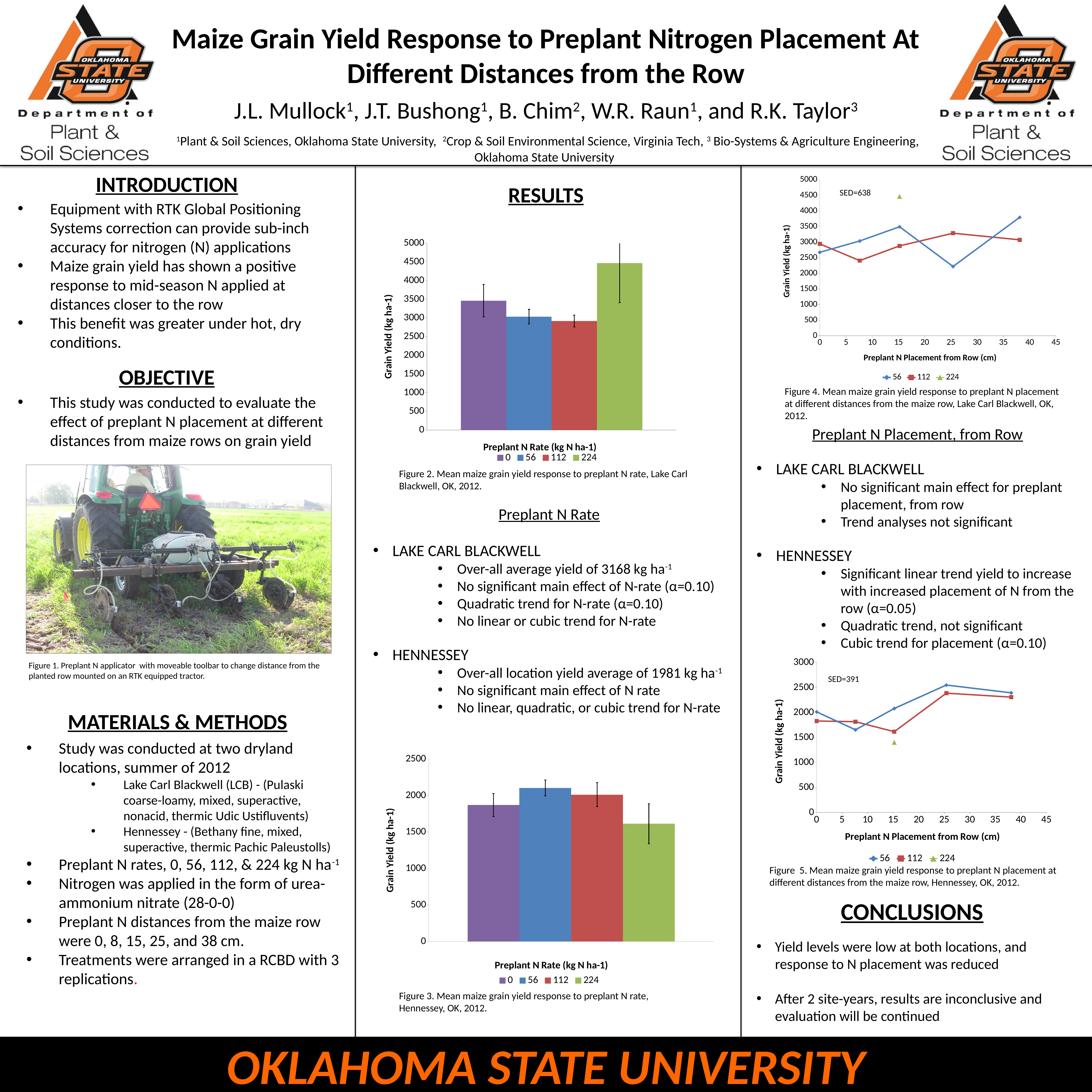
In Figure 2 (Lake Carl Blackwell, preplant N rate), what kind of chart is shown? bar chart In Figure 3 (Hennessey, preplant N rate), which N rate has the lowest grain yield? 224 In Figure 5 (Hennessey, preplant N placement), at 25 cm, which series has the higher grain yield, 56 or 112? 56 In Figure 5 (Hennessey, preplant N placement), what kind of chart is shown? line chart In Figure 2 (Lake Carl Blackwell, preplant N rate), how many N rates are plotted? 4 In Figure 3 (Hennessey, preplant N rate), is the grain yield for the 56 rate greater or less than 2000? greater In Figure 4 (Lake Carl Blackwell, preplant N placement), is the grain yield for the 56 series at 25 cm greater or less than 2500? less In Figure 2 (Lake Carl Blackwell, preplant N rate), which N rate has the highest grain yield? 224 In Figure 4 (Lake Carl Blackwell, preplant N placement), how many series does the legend list? 3 In Figure 2 (Lake Carl Blackwell, preplant N rate), is the grain yield for the 224 rate greater or less than 4000? greater